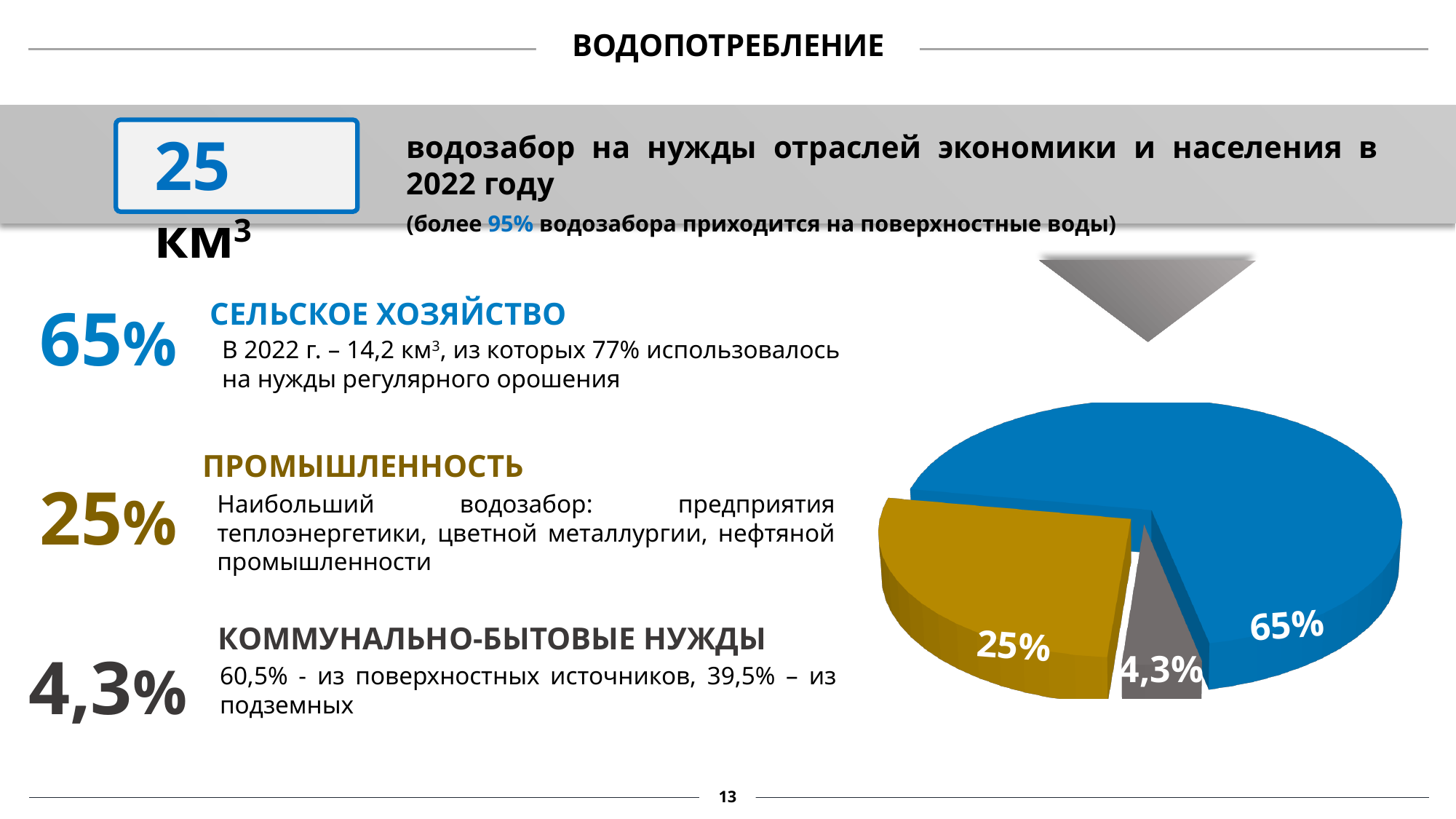
What value is labelled on the gold slice of the pie chart? 25% Which slice of the pie chart is larger, the blue one or the gold one? the blue one (65%) What value is labelled on the grey slice of the pie chart? 4,3% What is the value of the largest slice of the pie chart? 65% What is the difference between the blue slice (65%) and the gold slice (25%) of the pie chart? 40% How many slices does the pie chart have? 3 What is the difference between the gold slice (25%) and the grey slice (4,3%) of the pie chart? 20,7% What kind of chart is shown on the slide? pie chart What share of the pie chart does the slice for Сельское хозяйство (agriculture) take? 65% What colour is the largest slice of the pie chart? blue What value is labelled on the blue slice of the pie chart? 65% What is the value of the smallest slice of the pie chart? 4,3%